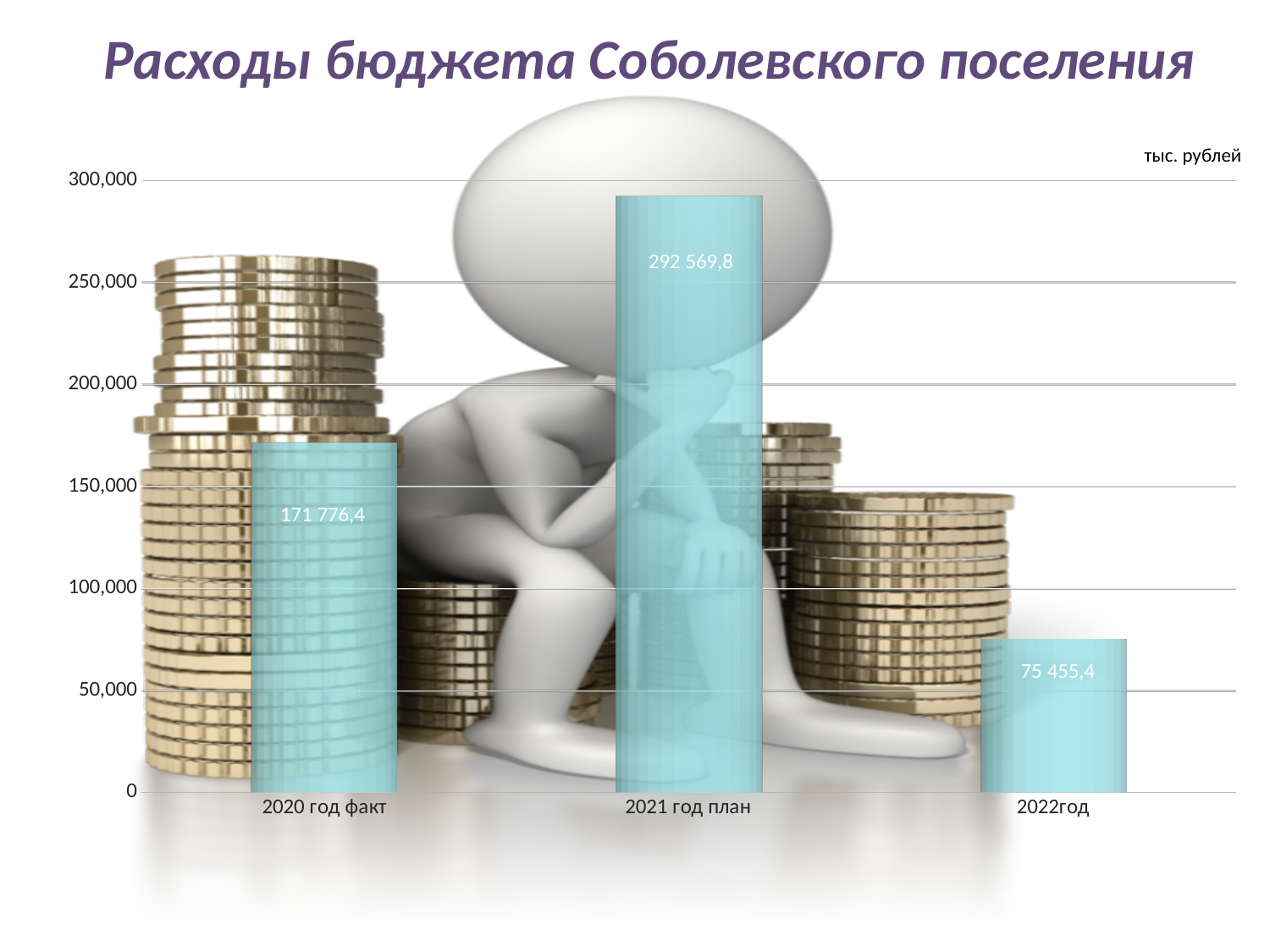
Which is larger, the value for 2020 год факт or the value for 2022год? 2020 год факт What is the difference between the values for 2021 год план and 2020 год факт? 120 793,4 Is the value for 2022год greater or less than 100,000? less How many categories are shown on the x axis? 3 What unit is indicated for the values on the chart? тыс. рублей What is the value for 2020 год факт? 171 776,4 Which category has the lowest value? 2022год What kind of chart is shown on the slide? bar chart What is the difference between the values for 2020 год факт and 2022год? 96 321,0 What is the value for 2022год? 75 455,4 What is the value for 2021 год план? 292 569,8 Which category has the highest value? 2021 год план